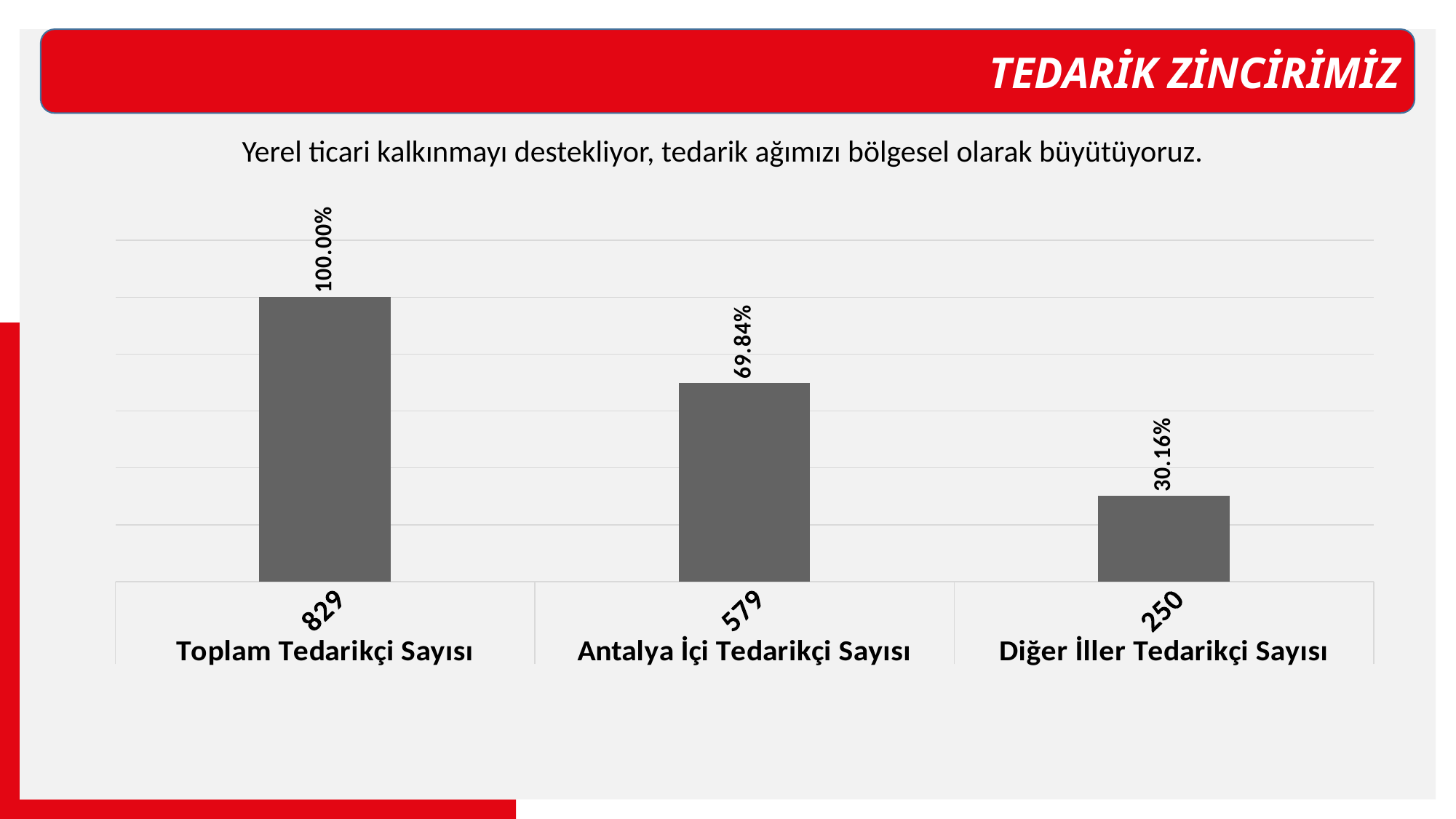
Which category has the lowest value? Diğer İller Tedarikçi Sayısı What is the difference between the percentages for Toplam Tedarikçi Sayısı and Antalya İçi Tedarikçi Sayısı? 30.16% Which category has the highest value? Toplam Tedarikçi Sayısı Do the values rise or fall from left to right across the categories? Fall What number is printed on the category axis under Antalya İçi Tedarikçi Sayısı? 579 What is the difference between the percentages for Antalya İçi Tedarikçi Sayısı and Diğer İller Tedarikçi Sayısı? 39.68% How many categories are shown in the chart? 3 What percentage is shown for Antalya İçi Tedarikçi Sayısı? 69.84% What percentage is shown for Diğer İller Tedarikçi Sayısı? 30.16% What kind of chart is shown on the slide? Bar chart What percentage is shown for Toplam Tedarikçi Sayısı? 100.00% Which is larger, the value for Antalya İçi Tedarikçi Sayısı or the value for Diğer İller Tedarikçi Sayısı? Antalya İçi Tedarikçi Sayısı